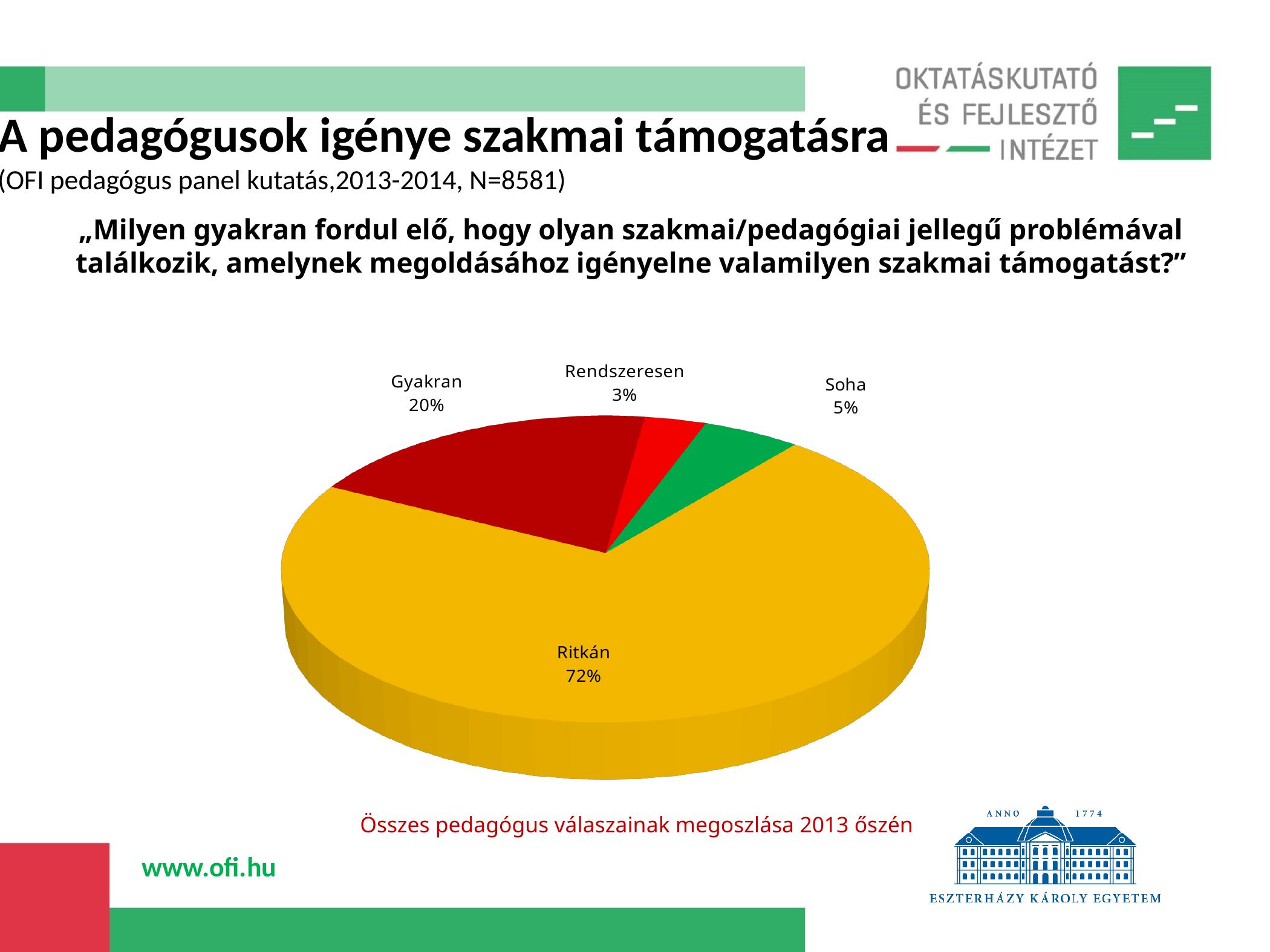
What percentage of respondents answered "Soha"? 5% What percentage of respondents answered "Ritkán"? 72% What kind of chart is shown on the slide? Pie chart Which category has the smallest share of the pie? Rendszeresen What is the difference in percentage points between "Ritkán" and "Gyakran"? 52 How many categories are shown in the pie chart? 4 Which is larger, the share for "Soha" or the share for "Rendszeresen"? Soha What is the difference in percentage points between "Soha" and "Rendszeresen"? 2 What colour is the "Soha" slice? Green What percentage of respondents answered "Rendszeresen"? 3% Which category has the largest share of the pie? Ritkán What percentage of respondents answered "Gyakran"? 20%